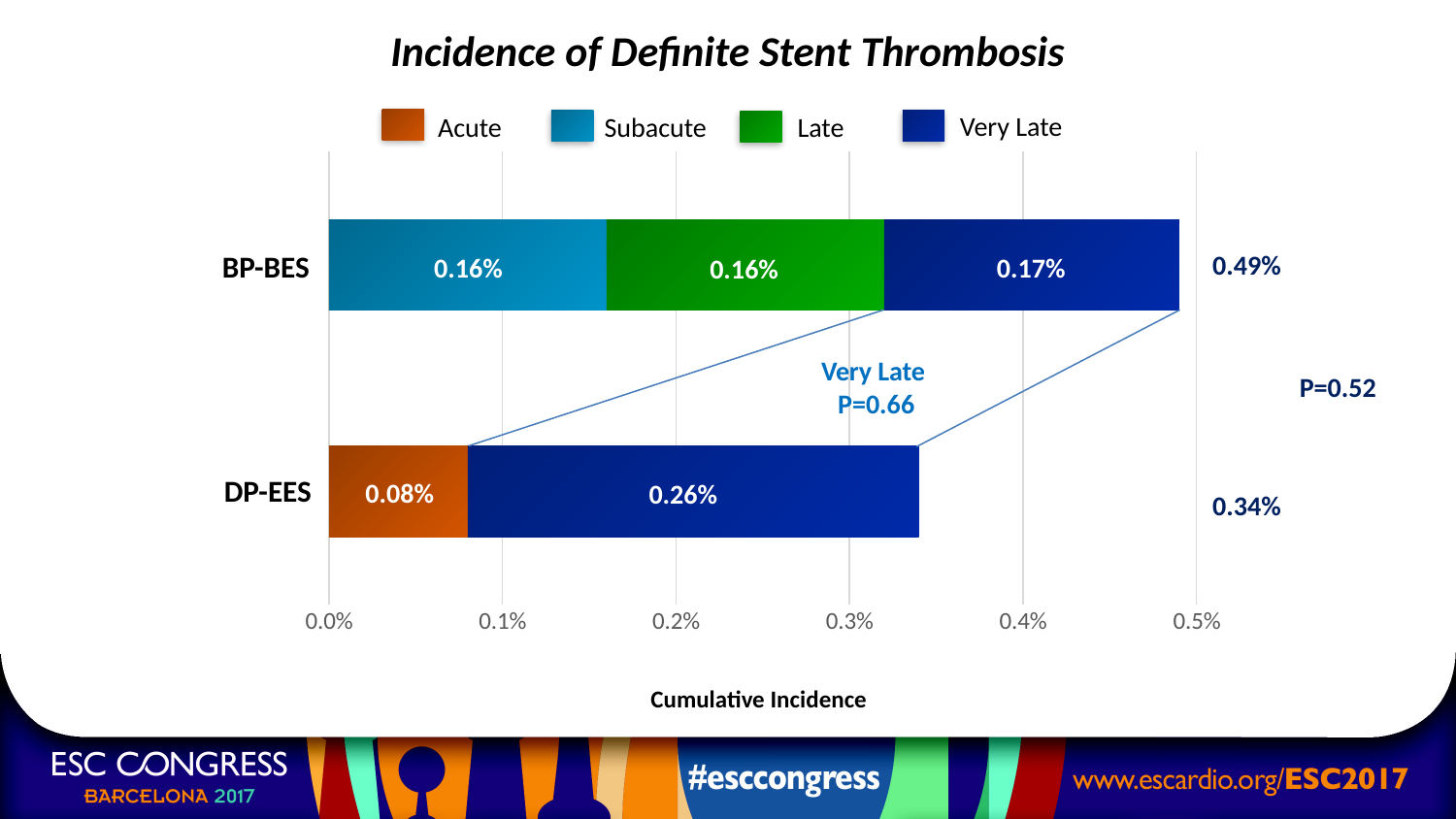
What is the difference between the Very Late values for DP-EES and BP-BES? 0.09% What is the Acute value for DP-EES? 0.08% How many groups (bars) are shown on the chart? 2 How many series does the legend list? 4 What kind of chart is shown? Stacked bar chart What is the Very Late value for DP-EES? 0.26% What is the total cumulative incidence shown for the DP-EES bar? 0.34% What is the Subacute value for BP-BES? 0.16% What is the Very Late value for BP-BES? 0.17% Which group has the higher total cumulative incidence, BP-BES or DP-EES? BP-BES What is the title of the chart? Incidence of Definite Stent Thrombosis What is the total cumulative incidence shown for the BP-BES bar? 0.49%